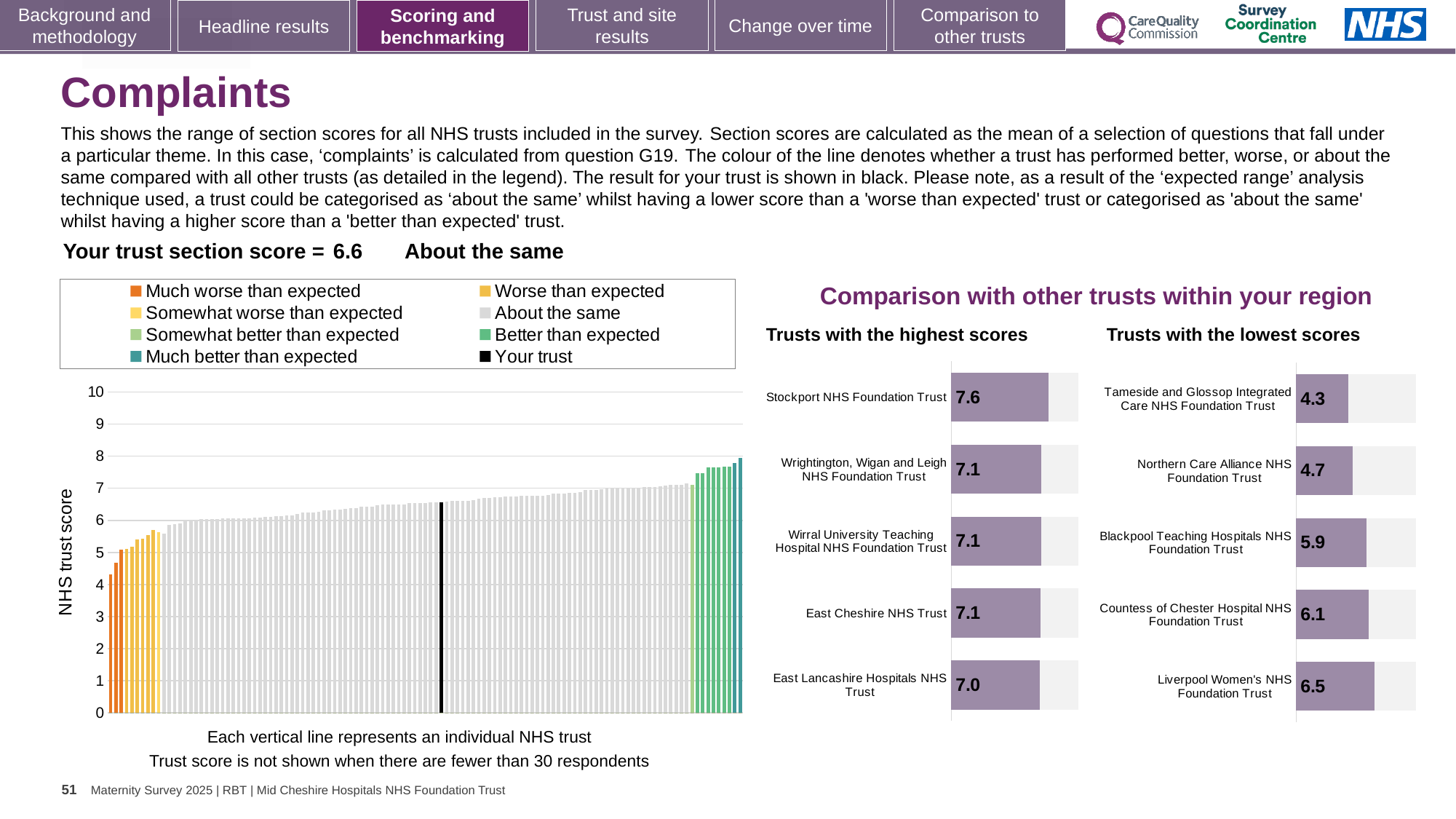
In the 'Trusts with the lowest scores' chart, which trust has the lowest score? Tameside and Glossop Integrated Care NHS Foundation Trust How many trusts are listed in the 'Trusts with the highest scores' chart? 5 In the 'Trusts with the highest scores' chart, which trust has the highest score? Stockport NHS Foundation Trust In the 'Trusts with the highest scores' chart, what is the difference between the scores of Stockport NHS Foundation Trust and East Lancashire Hospitals NHS Trust? 0.6 In the 'Trusts with the highest scores' chart, what is the score for Stockport NHS Foundation Trust? 7.6 In the 'Trusts with the lowest scores' chart, what is the score for Blackpool Teaching Hospitals NHS Foundation Trust? 5.9 In the 'Trusts with the lowest scores' chart, which has the higher score: Northern Care Alliance NHS Foundation Trust or Countess of Chester Hospital NHS Foundation Trust? Countess of Chester Hospital NHS Foundation Trust How many entries does the legend of the NHS trust score chart on the left list? 8 In the NHS trust score chart on the left, is the value for the black 'Your trust' bar greater or less than 6? greater In the NHS trust score chart on the left, do the bar values rise or fall from left to right? rise What kind of chart is the NHS trust score chart on the left? bar chart In the 'Trusts with the lowest scores' chart, what is the difference between the scores of Liverpool Women's NHS Foundation Trust and Tameside and Glossop Integrated Care NHS Foundation Trust? 2.2